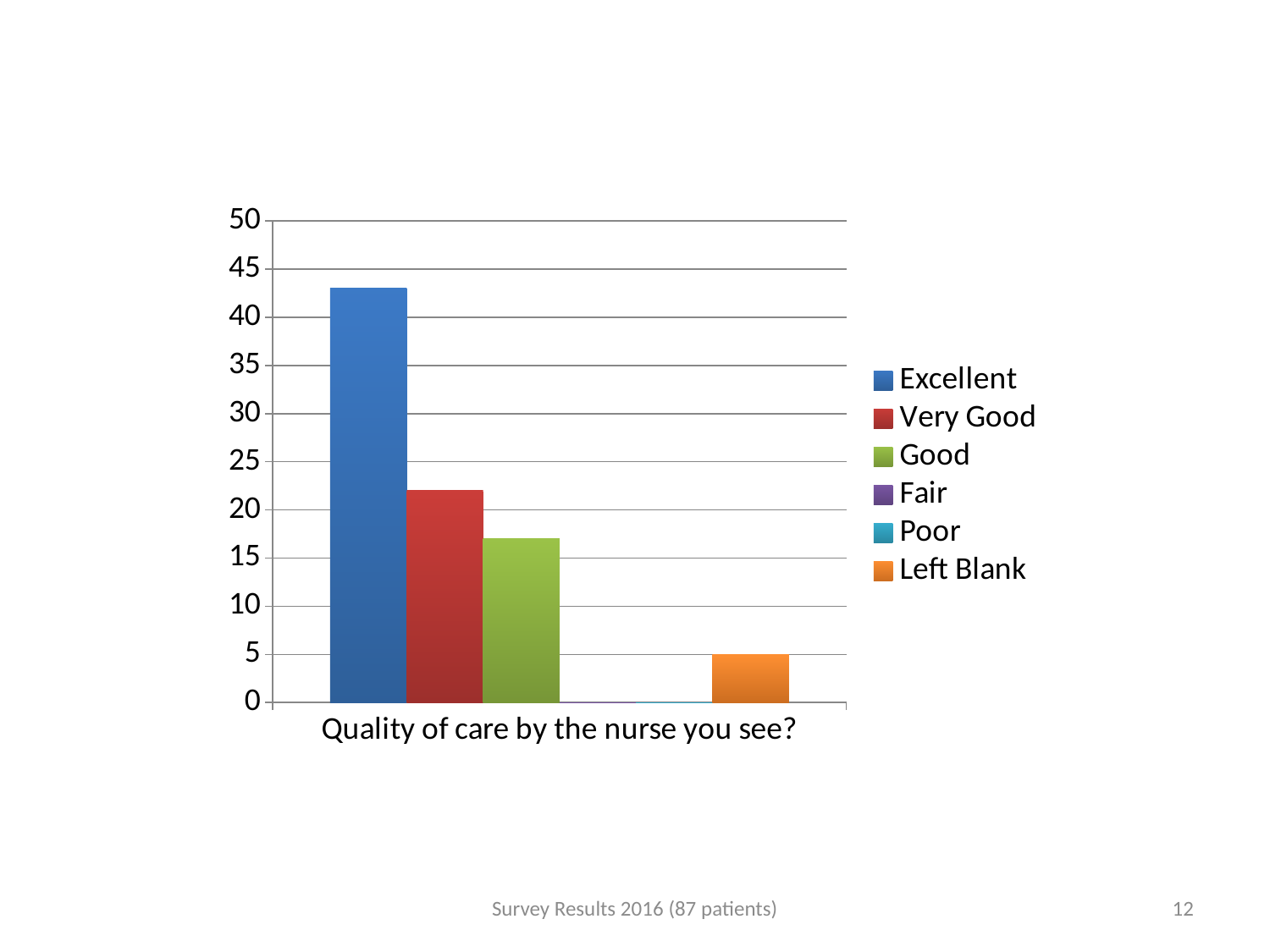
How many series does the legend list? 6 What kind of chart is shown on the slide? bar chart Which is larger, the value for Left Blank or the value for Good? Good What question is shown as the category label beneath the bars? Quality of care by the nurse you see? Is the value for Very Good greater or less than 25? less Is the value for Very Good greater or less than 20? greater Is the value for Excellent greater or less than 40? greater Which legend entry is shown in orange? Left Blank Which response category has the highest value? Excellent Which is larger, the value for Very Good or the value for Good? Very Good